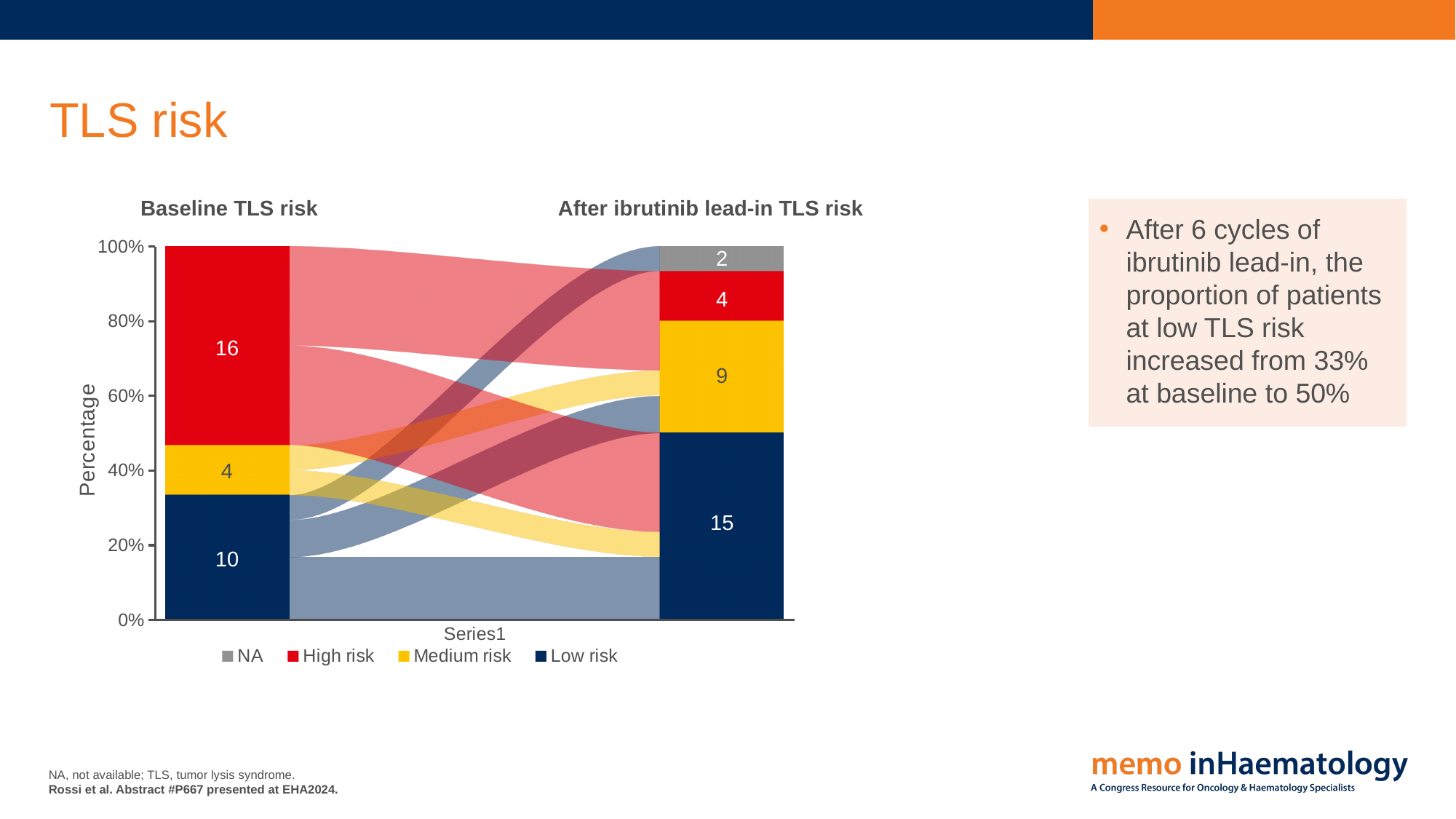
How many series does the legend list? 4 What is the label of the y axis? Percentage Is the Low risk value larger at baseline or after ibrutinib lead-in? After ibrutinib lead-in Which risk category has the largest value in the Baseline TLS risk bar? High risk Which category has the smallest value in the After ibrutinib lead-in TLS risk bar? NA What is the value for High risk in the Baseline TLS risk bar? 16 What kind of chart is shown on the slide? Stacked bar chart What is the difference between the High risk values at baseline and after ibrutinib lead-in? 12 What is the total of the Baseline TLS risk stacked bar? 30 What is the value for NA in the After ibrutinib lead-in TLS risk bar? 2 What is the value for Low risk in the After ibrutinib lead-in TLS risk bar? 15 What is the value for Medium risk in the After ibrutinib lead-in TLS risk bar? 9